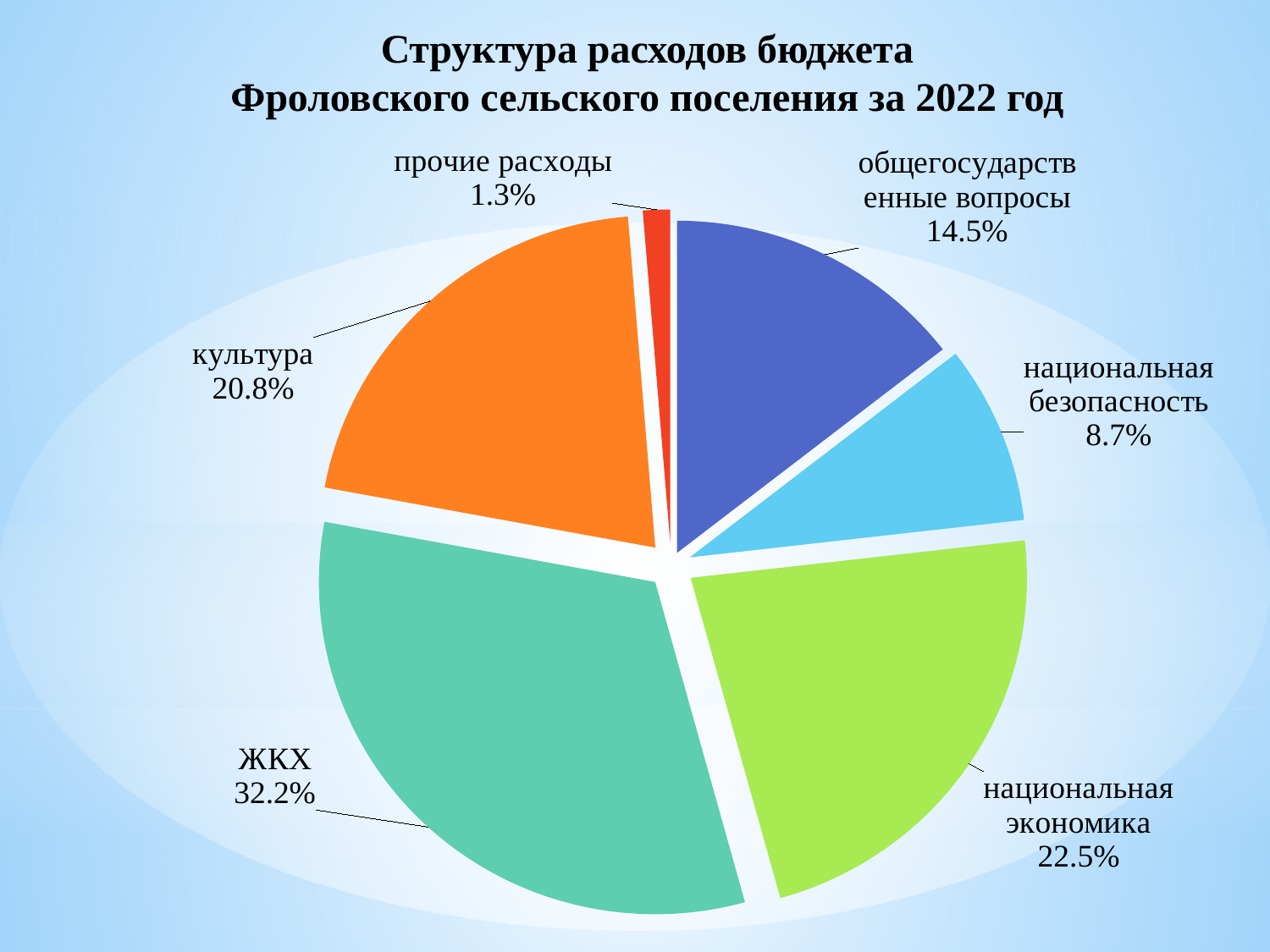
What percentage is shown for культура? 20.8% What is the difference in percentage points between ЖКХ and национальная экономика? 9.7 Which category has the smallest share of the pie? прочие расходы How many categories are shown in the pie chart? 6 What share is labelled for национальная безопасность? 8.7% What year does the chart title say the budget expenditure structure is for? 2022 What is the combined share of национальная безопасность and прочие расходы? 10.0% What kind of chart is shown on the slide? pie chart Which category has the largest share of the pie? ЖКХ What percentage is shown for общегосударственные вопросы? 14.5% What share of the budget expenditure goes to ЖКХ? 32.2% Which is larger, the share for культура or the share for общегосударственные вопросы? культура